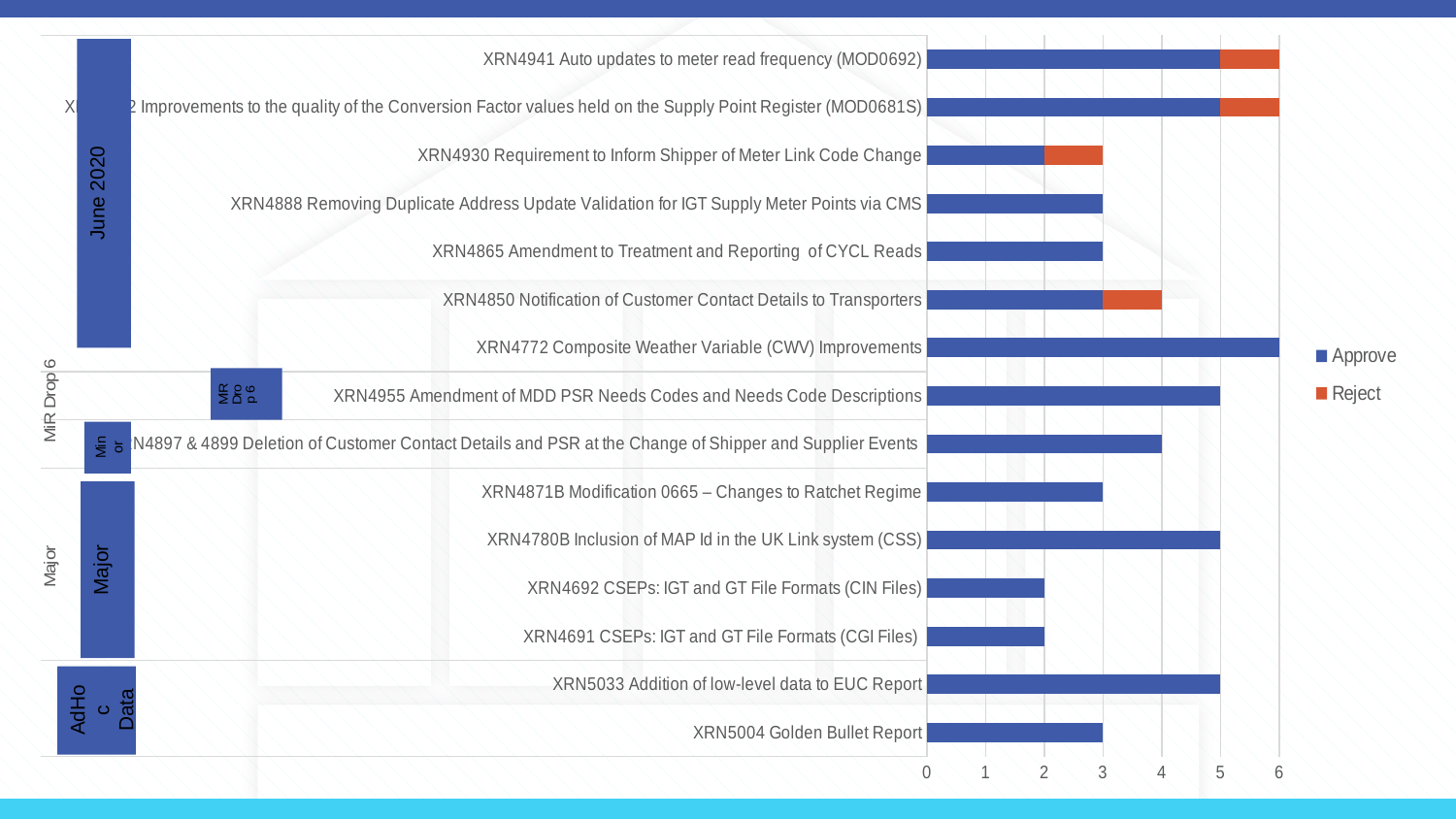
What is the difference between the Approve values for XRN4780B Inclusion of MAP Id in the UK Link system (CSS) and XRN4692 CSEPs: IGT and GT File Formats (CIN Files)? 3 What kind of chart is shown on the slide? Bar chart What is the Reject value for XRN4930 Requirement to Inform Shipper of Meter Link Code Change? 1 What is the Approve value for XRN4772 Composite Weather Variable (CWV) Improvements? 6 Which has a larger Approve value, XRN5033 Addition of low-level data to EUC Report or XRN4871B Modification 0665 – Changes to Ratchet Regime? XRN5033 Addition of low-level data to EUC Report How many XRN items (categories) are plotted in the chart? 15 What is the total of the stacked bar for XRN4850 Notification of Customer Contact Details to Transporters? 4 How many series does the legend list? 2 What is the Approve value for XRN5004 Golden Bullet Report? 3 What is the total of the stacked bar for XRN4941 Auto updates to meter read frequency (MOD0692)? 6 Which item has the highest Approve value? XRN4772 Composite Weather Variable (CWV) Improvements Which series is shown in orange in the legend? Reject